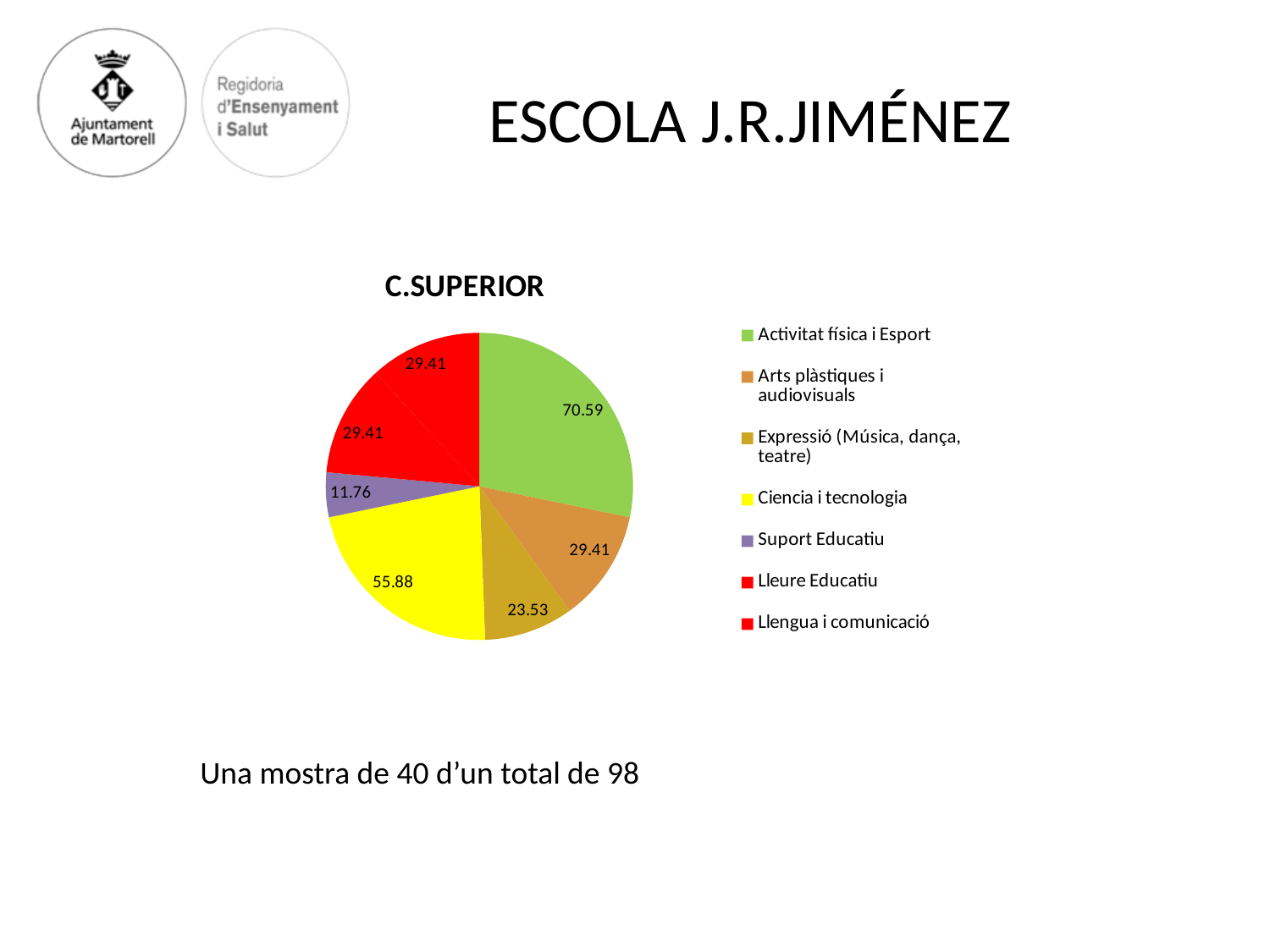
What is the value for Expressió (Música, dança, teatre)? 23.53 What is the value for Suport Educatiu? 11.76 Which category has the largest slice of the pie? Activitat física i Esport What is the value for Activitat física i Esport? 70.59 What is the value for Ciencia i tecnologia? 55.88 What is the title of the chart? C.SUPERIOR Which is larger, the value for Expressió (Música, dança, teatre) or the value for Arts plàstiques i audiovisuals? Arts plàstiques i audiovisuals Which category has the smallest slice of the pie? Suport Educatiu What type of chart is shown on the slide? pie chart How many categories does the legend list? 7 What is the value for Arts plàstiques i audiovisuals? 29.41 What is the difference between the values for Activitat física i Esport and Ciencia i tecnologia? 14.71